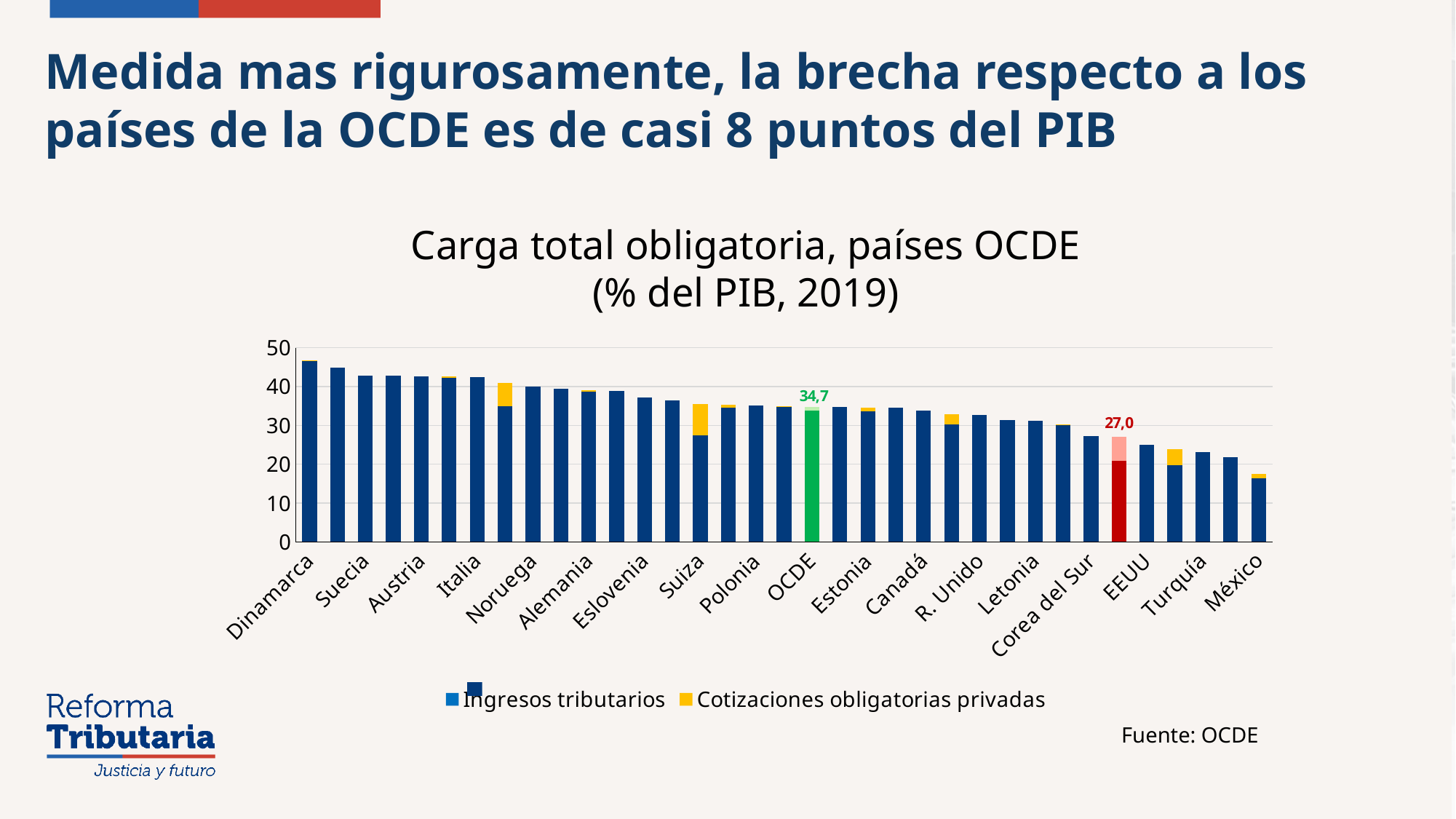
Is the value for Dinamarca greater or less than 40? greater Is the value for México greater or less than 20? less What kind of chart is shown on the slide? bar chart Is the value for Corea del Sur greater or less than 30? less How many series does the legend list? 2 Which country has the lowest total mandatory burden in the chart? México Which is larger, the value for Suecia or the value for Polonia? Suecia Which country has the highest total mandatory burden in the chart? Dinamarca Do the values rise or fall moving from left to right along the x axis? fall What is the value printed for OCDE in the chart? 34,7